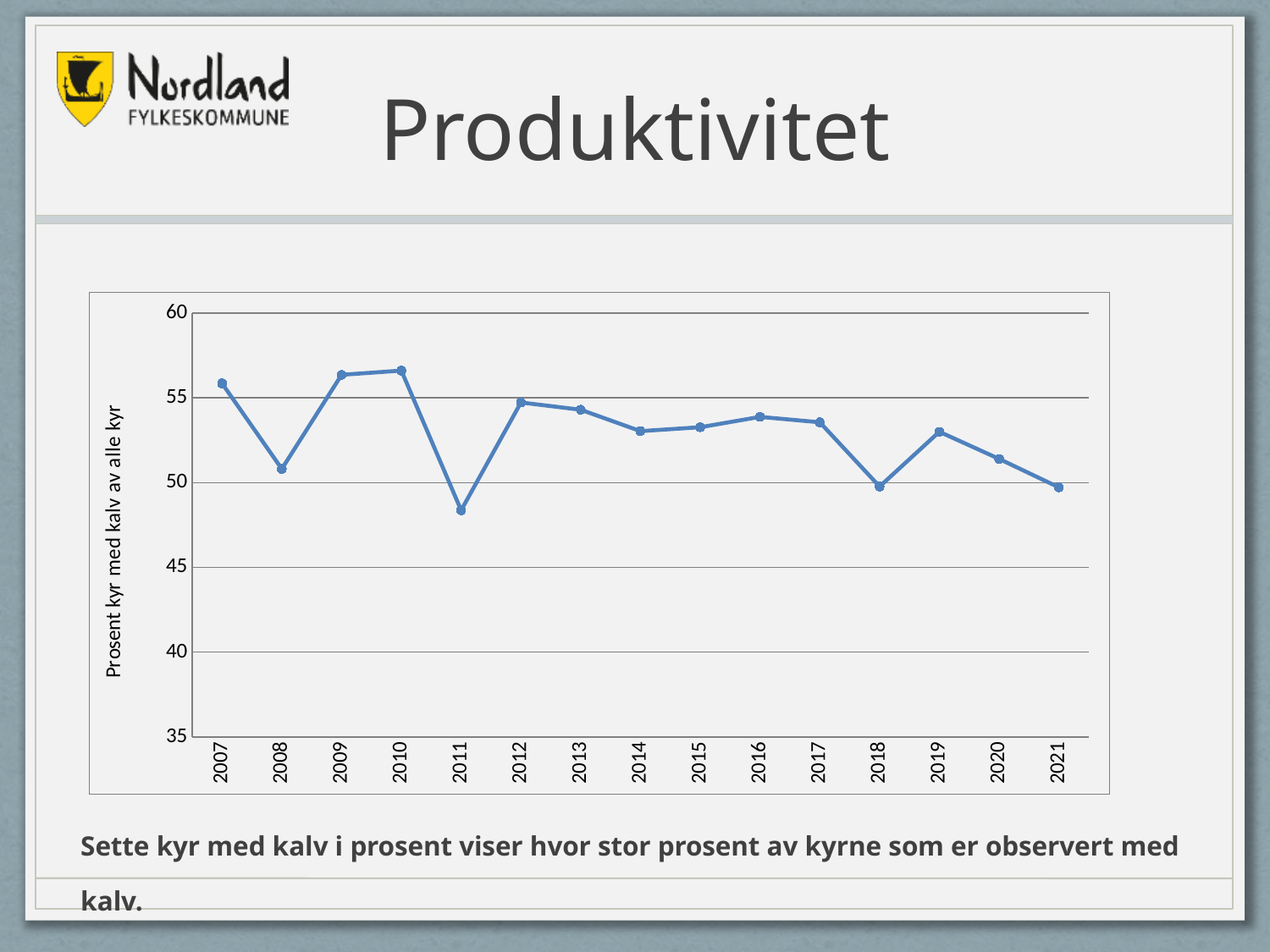
What is the label on the y axis of the chart? Prosent kyr med kalv av alle kyr Is the value for 2009 greater or less than 55? greater Overall, does the plotted value rise or fall from 2007 to 2021? fall Is the value for 2014 greater or less than 50? greater Which year has the larger value, 2007 or 2008? 2007 What kind of chart is shown on the slide? line chart How many years are plotted on the x axis of the chart? 15 Is the value for 2007 greater or less than 55? greater Which year has the larger value, 2011 or 2012? 2012 Which year has the lowest value in the chart? 2011